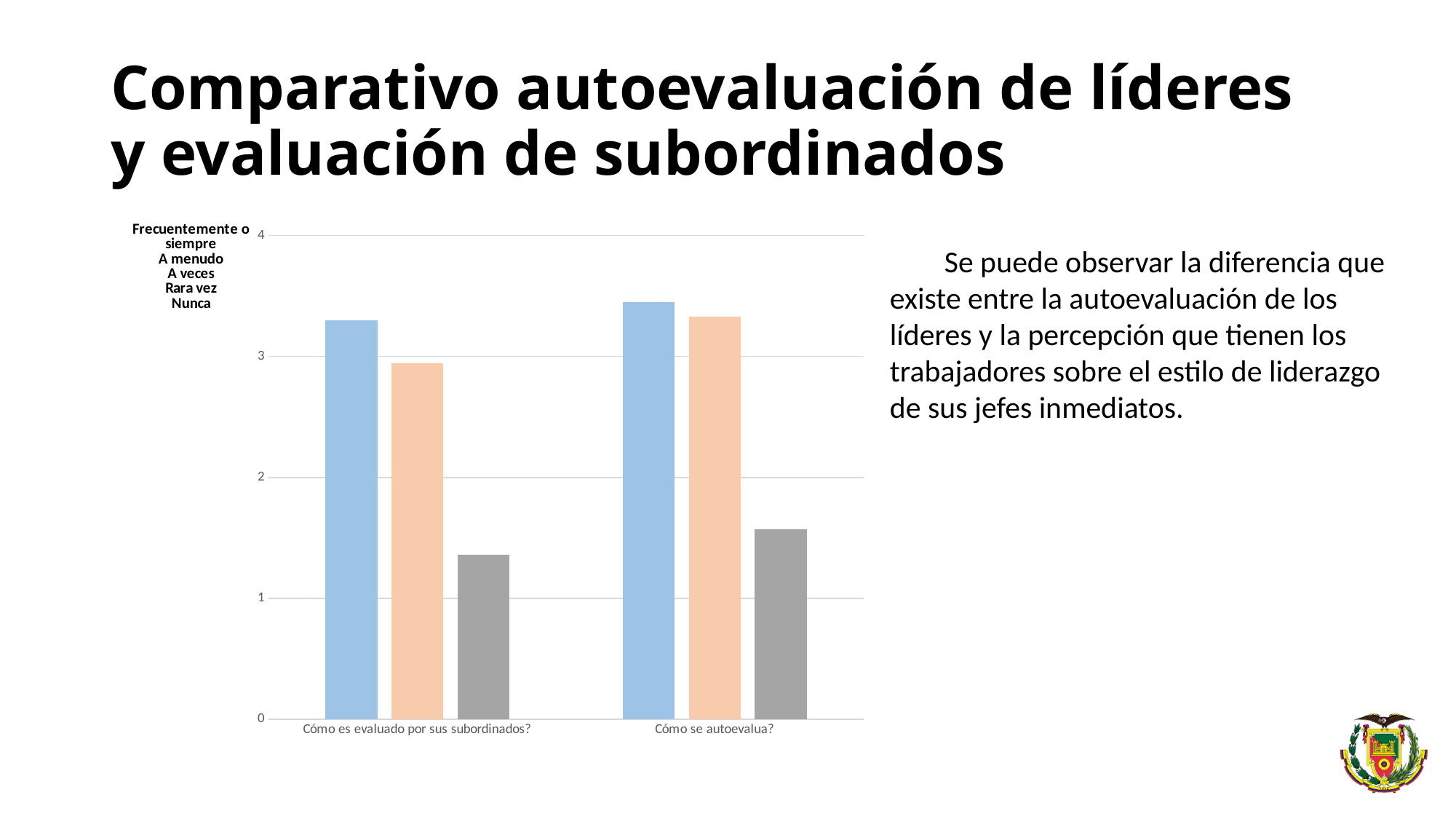
Is the orange bar for "Cómo se autoevalua?" greater or less than 3? greater Is the blue bar for "Cómo se autoevalua?" greater or less than 3? greater Which bar is the tallest in the category "Cómo es evaluado por sus subordinados?"? the blue bar Is the gray bar for "Cómo es evaluado por sus subordinados?" greater or less than 2? less How many bars are plotted for the category "Cómo se autoevalua?"? 3 How many categories are shown on the x axis of the chart? 2 Which is taller: the orange bar for "Cómo es evaluado por sus subordinados?" or the orange bar for "Cómo se autoevalua?"? Cómo se autoevalua? Which is taller: the gray bar for "Cómo es evaluado por sus subordinados?" or the gray bar for "Cómo se autoevalua?"? Cómo se autoevalua? What kind of chart is shown on the slide? bar chart Which bar is the shortest in the category "Cómo se autoevalua?"? the gray bar What is the highest value shown on the chart's y axis? 4